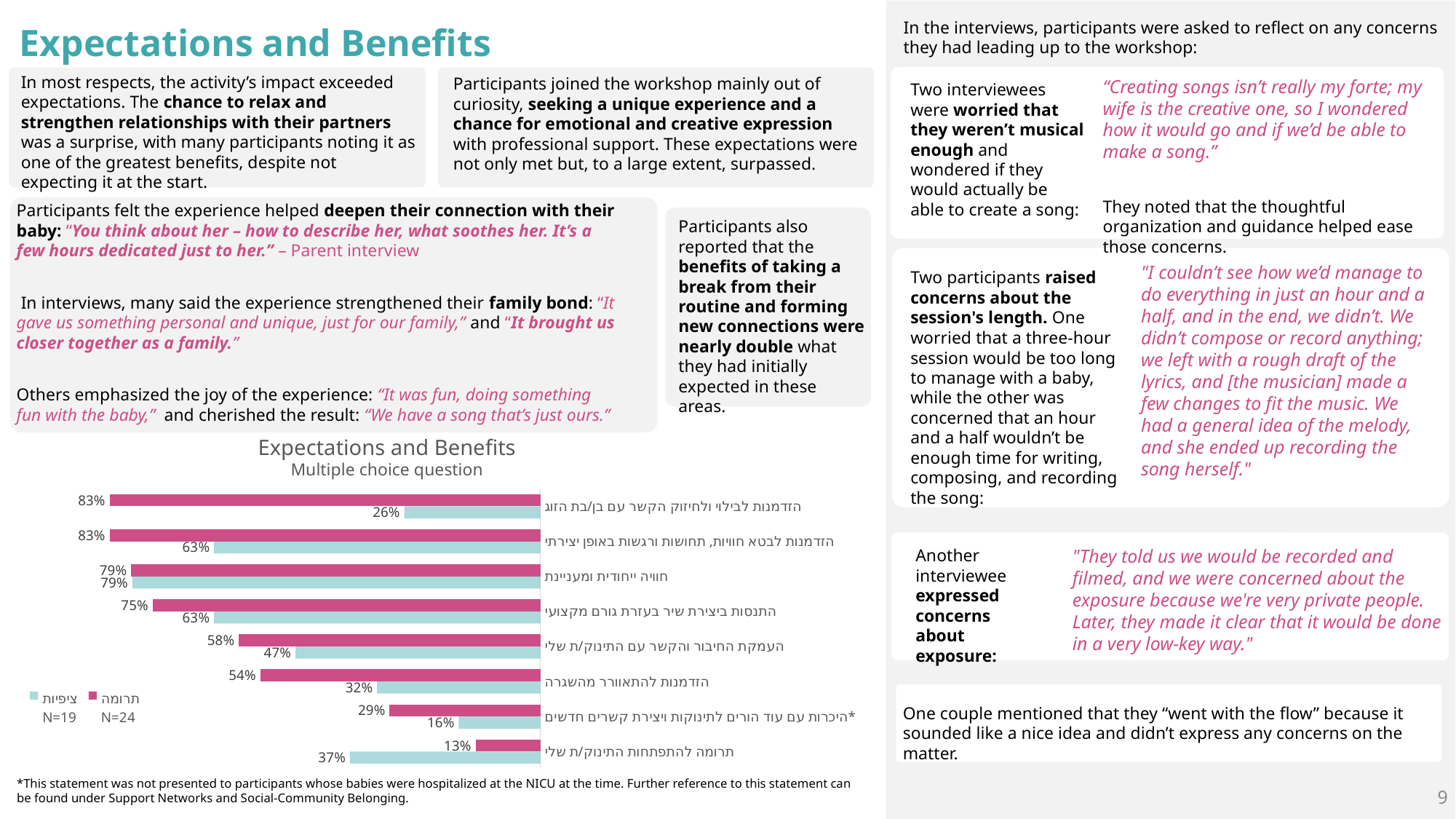
In the "Expectations and Benefits" chart, which category has the highest ציפיות value? חוויה ייחודית ומעניינת In the "Expectations and Benefits" chart, what is the difference between the תרומה and ציפיות values for "העמקת החיבור והקשר עם התינוק/ת שלי"? 11% In the "Expectations and Benefits" chart, what is the difference between the תרומה and ציפיות values for "הזדמנות להתאוורר מהשגרה"? 22% What kind of chart is shown under the title "Expectations and Benefits"? Bar chart In the "Expectations and Benefits" chart, what is the ציפיות value for "הזדמנות לבילוי ולחיזוק הקשר עם בן/בת הזוג"? 26% In the "Expectations and Benefits" chart, what is the תרומה value for "הזדמנות לבילוי ולחיזוק הקשר עם בן/בת הזוג"? 83% In the "Expectations and Benefits" chart, which category has the lowest תרומה value? תרומה להתפתחות התינוק/ת שלי In the "Expectations and Benefits" chart, which is larger for "תרומה להתפתחות התינוק/ת שלי": the ציפיות value or the תרומה value? ציפיות How many series does the legend of the "Expectations and Benefits" chart list? 2 How many categories are plotted in the "Expectations and Benefits" chart? 8 What sample size (N) does the legend of the "Expectations and Benefits" chart give for the ציפיות series? N=19 In the "Expectations and Benefits" chart, what is the ציפיות value for "תרומה להתפתחות התינוק/ת שלי"? 37%